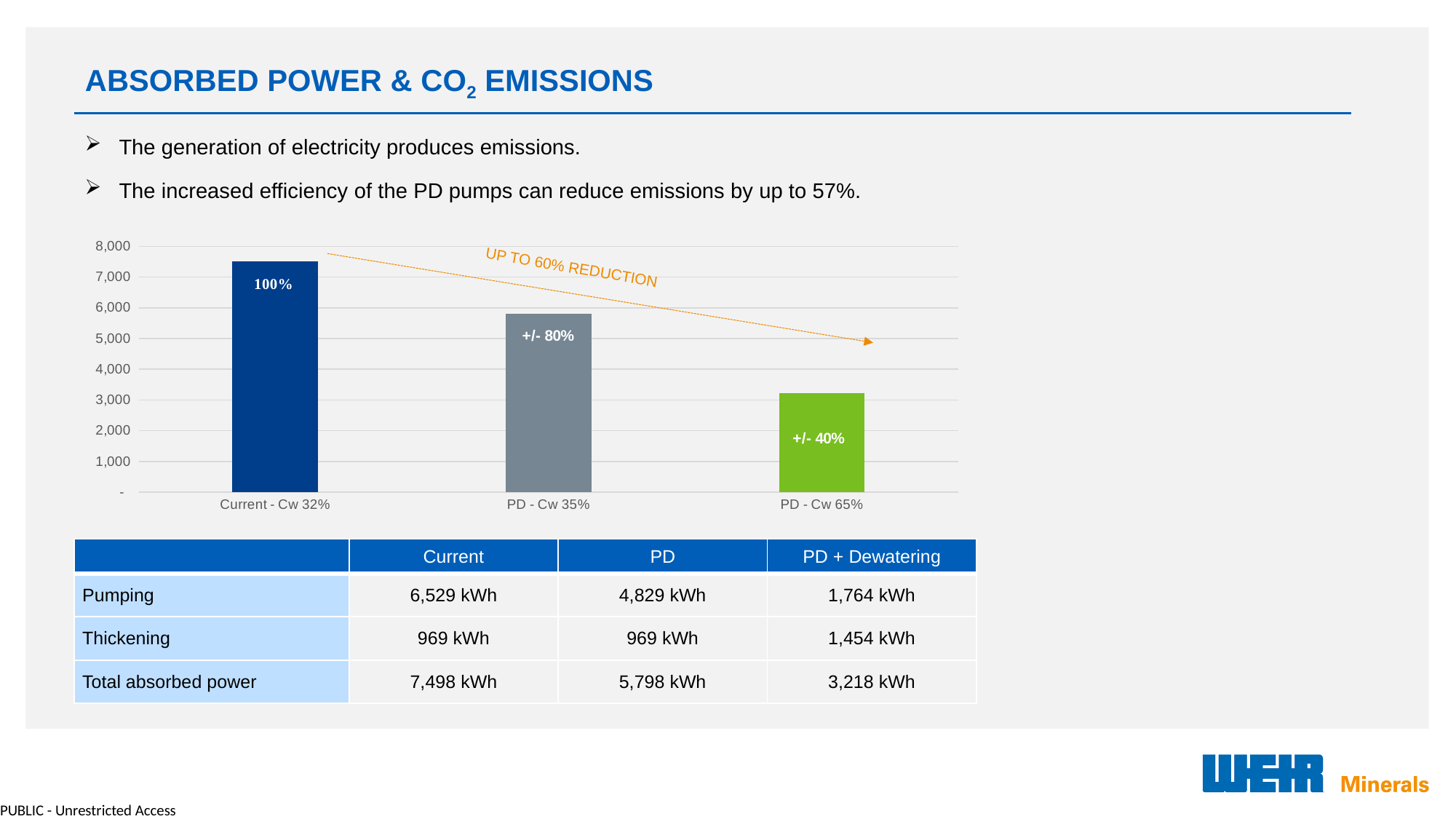
What label is printed on the bar for PD - Cw 65%? +/- 40% Which category has the lowest bar in the chart? PD - Cw 65% How many bars are plotted in the chart? 3 Do the bar values rise or fall from left to right across the chart? fall Is the value for PD - Cw 35% greater or less than 6,000? less Which category has the highest bar in the chart? Current - Cw 32% What label is printed on the bar for Current - Cw 32%? 100% Which bar is taller, PD - Cw 35% or PD - Cw 65%? PD - Cw 35% What label is printed on the bar for PD - Cw 35%? +/- 80% Is the value for PD - Cw 65% greater or less than 3,000? greater What kind of chart is shown on the slide? bar chart Is the value for Current - Cw 32% greater or less than 7,000? greater